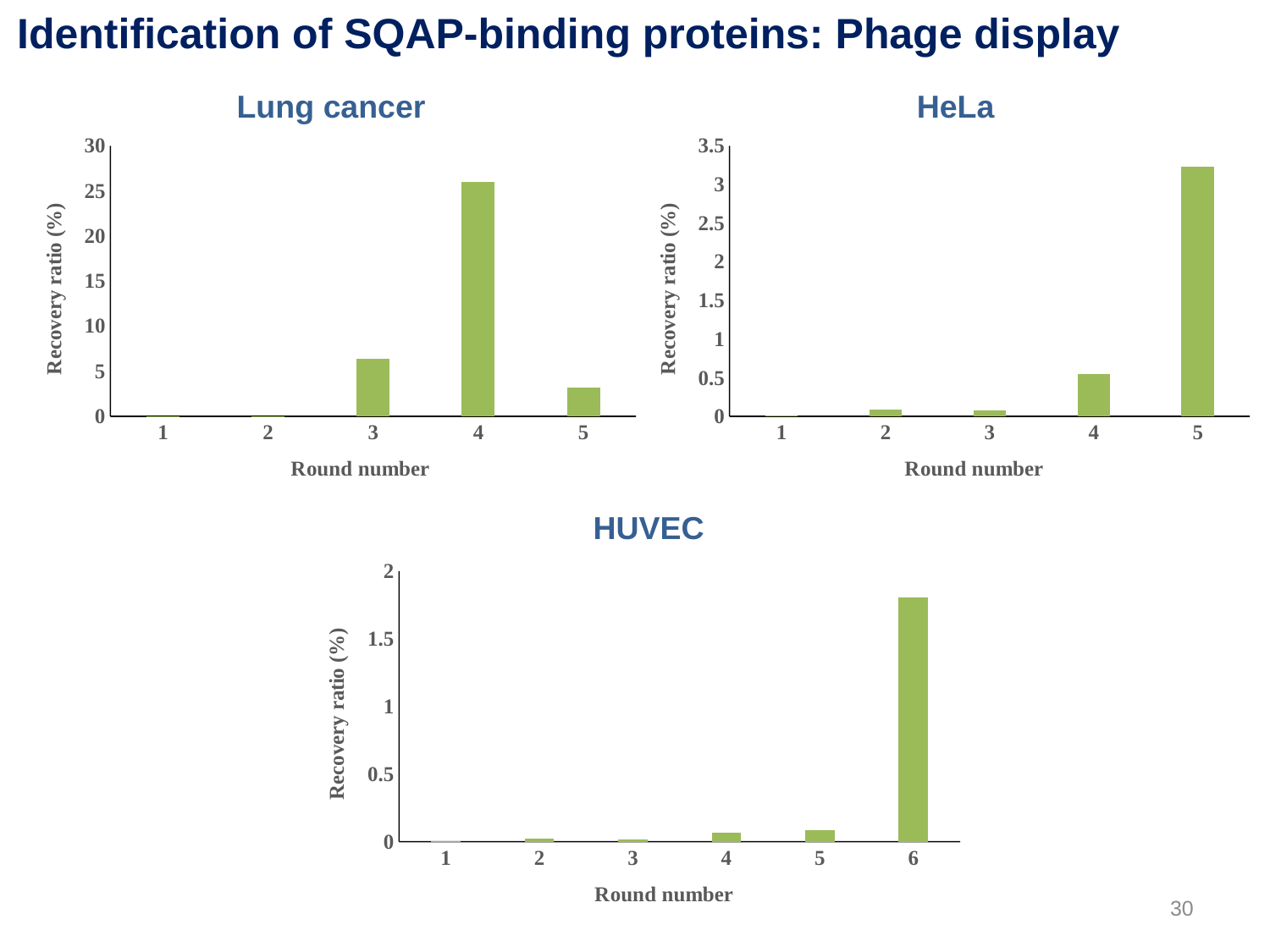
In the HUVEC chart, is the recovery ratio for round 6 greater or less than 1.5? greater How many round numbers are shown on the x axis of the HUVEC chart? 6 In the HeLa chart, is the recovery ratio for round 5 greater or less than 3? greater In the HeLa chart, which round number has the highest recovery ratio? 5 In the Lung cancer chart, which round number has the highest recovery ratio? 4 In the Lung cancer chart, is the recovery ratio for round 4 greater or less than 20? greater What type of chart is the Lung cancer chart? bar chart In the HUVEC chart, which round number has the highest recovery ratio? 6 In the Lung cancer chart, which has a higher recovery ratio, round 3 or round 5? round 3 What is the y-axis title of the HUVEC chart? Recovery ratio (%)